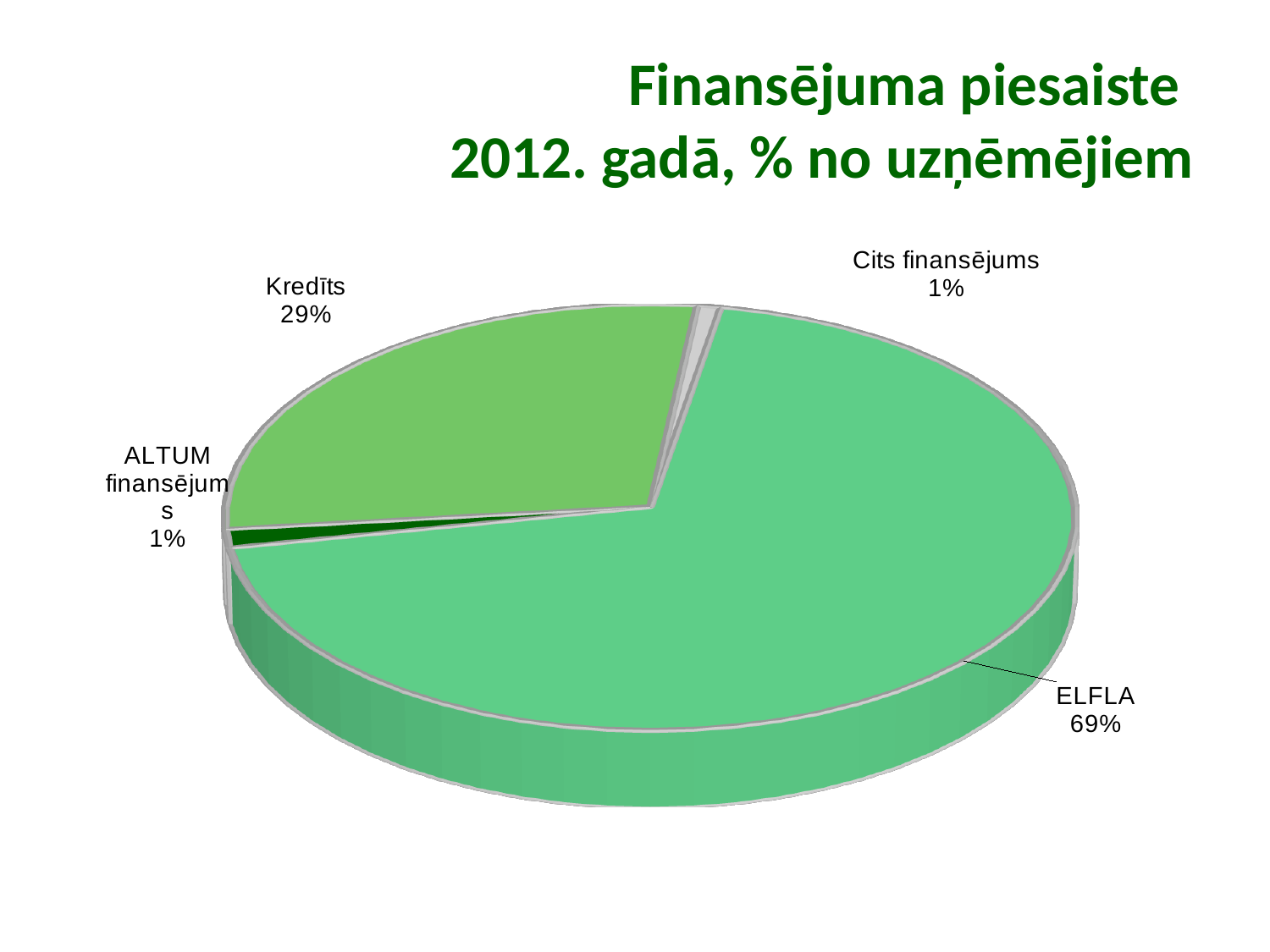
What share of the pie does ALTUM finansējums have? 1% What is the title of the chart? Finansējuma piesaiste 2012. gadā, % no uzņēmējiem Which is larger, the share for Kredīts or the share for ELFLA? ELFLA What is the difference in percentage points between ELFLA and Kredīts? 40 What share of the pie does Kredīts have? 29% What share of the pie does ELFLA have? 69% What kind of chart is shown on the slide? Pie chart Which category is shown in the dark green slice? ALTUM finansējums Which category has the largest slice of the pie? ELFLA How many categories are shown in the pie chart? 4 What is the combined share of ELFLA and Kredīts? 98%